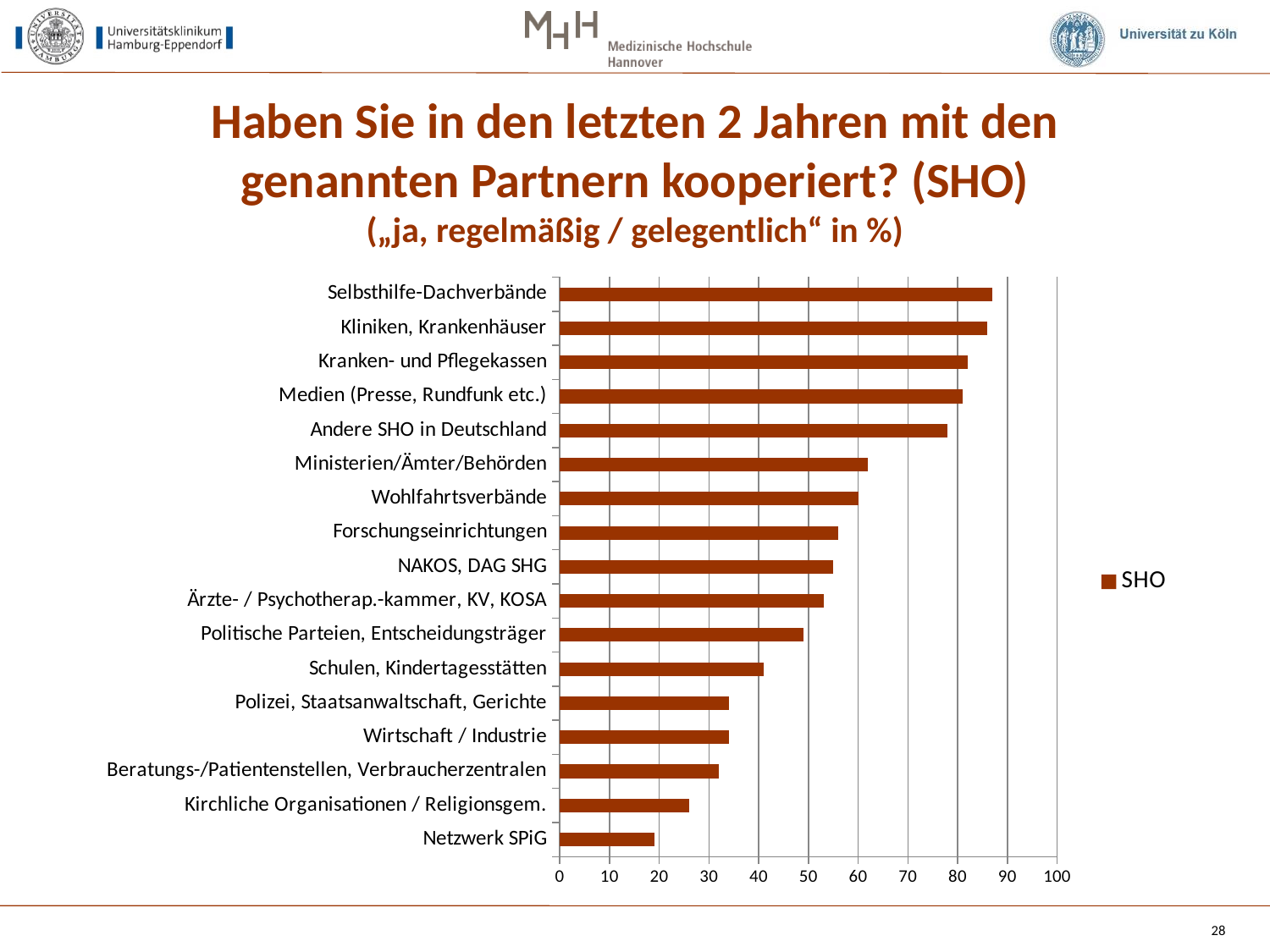
Is the value for Ministerien/Ämter/Behörden greater or less than 50? greater How many series does the legend list? 1 Is the value for Netzwerk SPiG greater or less than 30? less What is the name of the series shown in the legend? SHO Is the value for Schulen, Kindertagesstätten greater or less than 50? less Which has the larger value: Medien (Presse, Rundfunk etc.) or Ministerien/Ämter/Behörden? Medien (Presse, Rundfunk etc.) What kind of chart is shown on the slide? bar chart How many categories (partners) are listed on the chart? 17 Which partner has the lowest value on the chart? Netzwerk SPiG Which has the larger value: Forschungseinrichtungen or Schulen, Kindertagesstätten? Forschungseinrichtungen